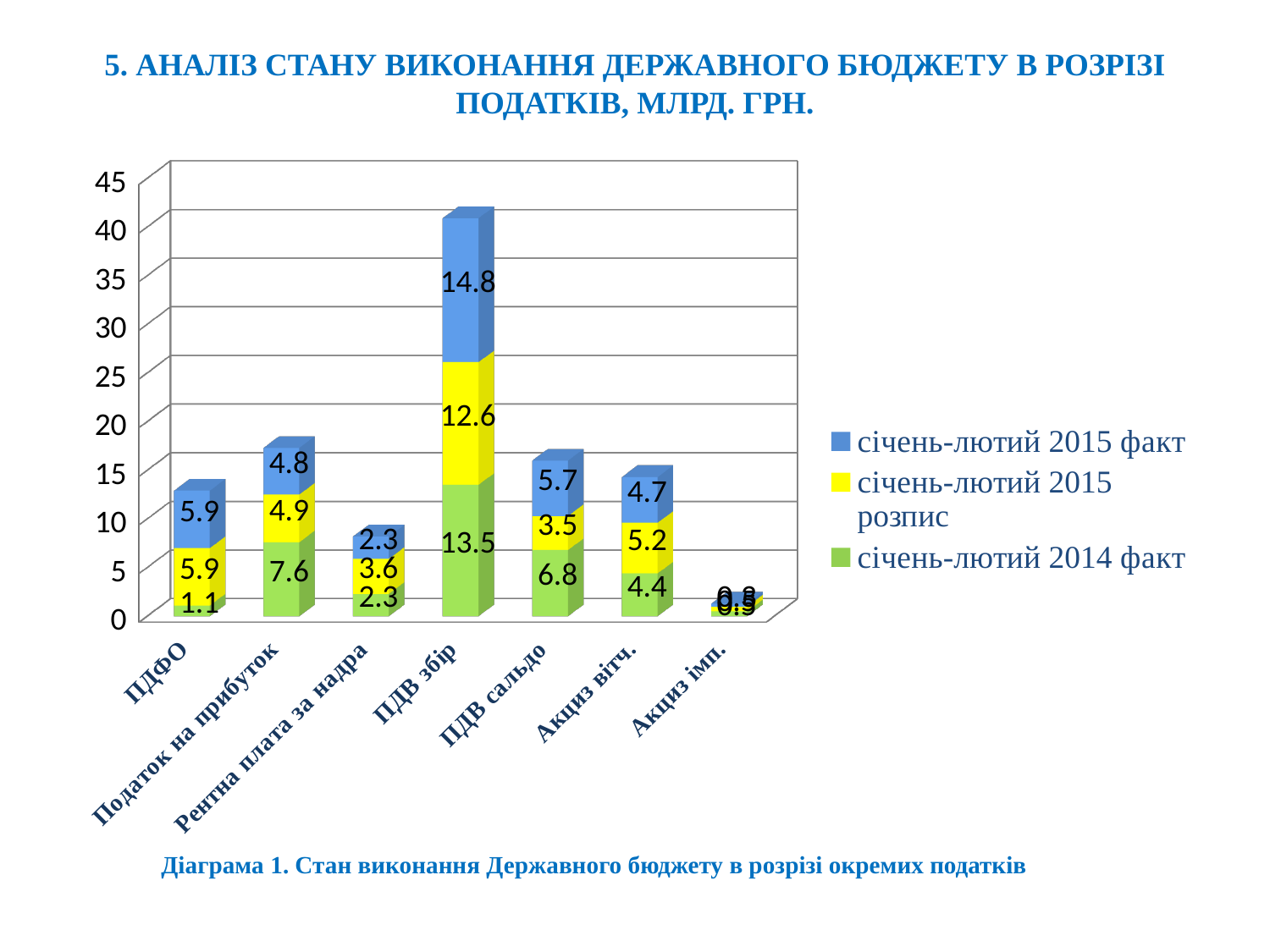
Which category has the shortest stacked bar? Акциз імп. What is the difference between the січень-лютий 2015 факт and січень-лютий 2014 факт values for ПДВ збір? 1.3 Which category has the tallest stacked bar? ПДВ збір Is the total stacked bar for ПДВ збір greater or less than 35? greater What is the total of the stacked bar for Рентна плата за надра? 8.2 Which is larger for ПДВ сальдо: the січень-лютий 2014 факт value or the січень-лютий 2015 розпис value? січень-лютий 2014 факт How many series does the legend list? 3 How many categories are shown on the x axis? 7 What is the value for ПДВ збір in the січень-лютий 2015 факт series? 14.8 What kind of chart is shown on the slide? stacked bar chart What is the value for Акциз вітч. in the січень-лютий 2015 розпис series? 5.2 What is the value for Податок на прибуток in the січень-лютий 2014 факт series? 7.6